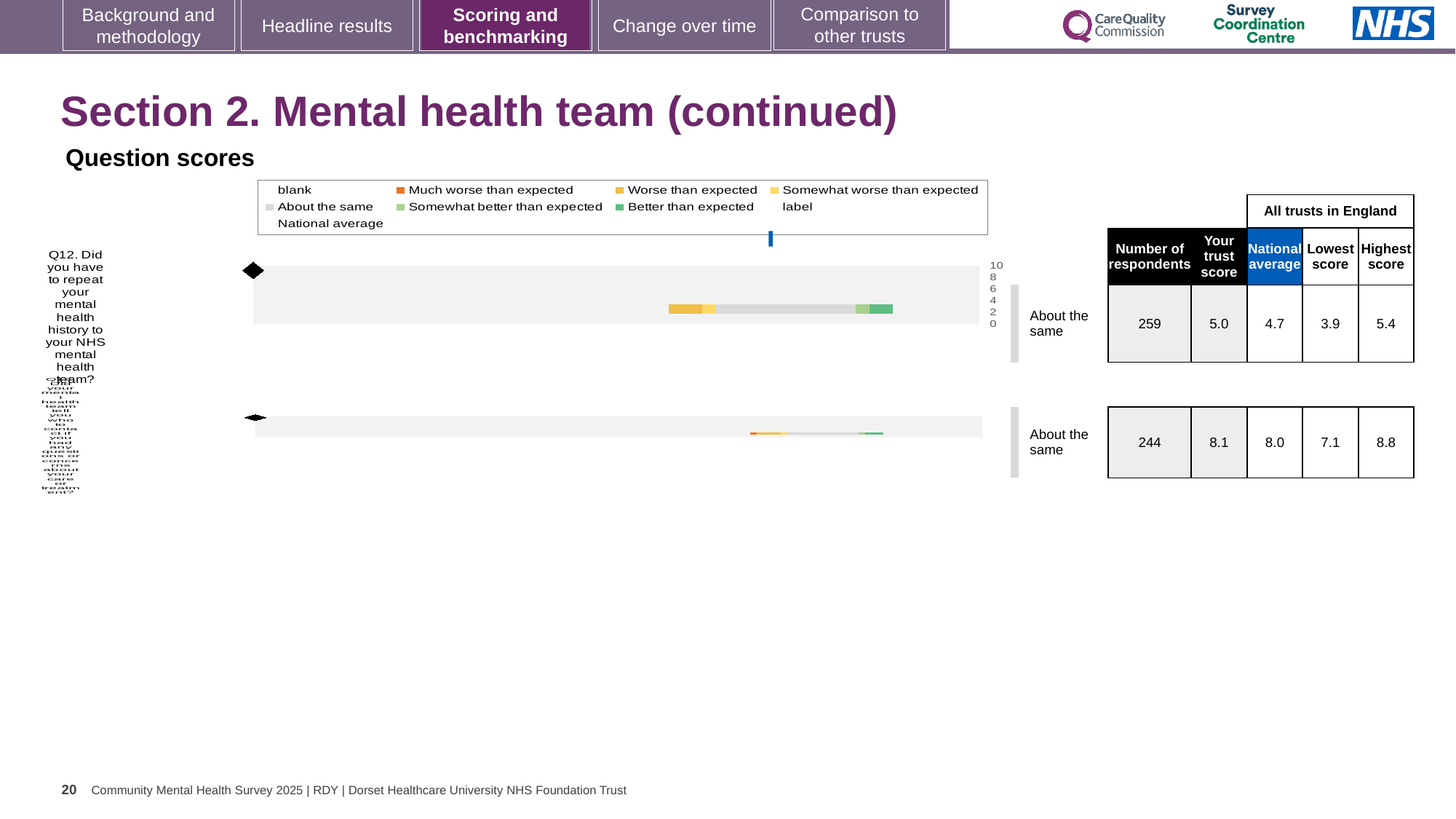
How many respondents answered Q12? 259 Which legend entry is shown in dark orange? Much worse than expected For Q12, which is larger: the trust score or the national average? the trust score For Q12, how much higher is the trust score than the national average? 0.3 How many questions are plotted on the chart? 2 What is the trust score for Q12 (Did you have to repeat your mental health history to your NHS mental health team?)? 5.0 What kind of chart is shown on the slide? bar chart What benchmark category is Q12 placed in? About the same What is the highest score among all trusts in England for Q12? 5.4 What is the national average score for Q12? 4.7 What is the lowest score among all trusts in England for Q12? 3.9 For Q12, what is the difference between the highest and lowest scores among all trusts in England? 1.5